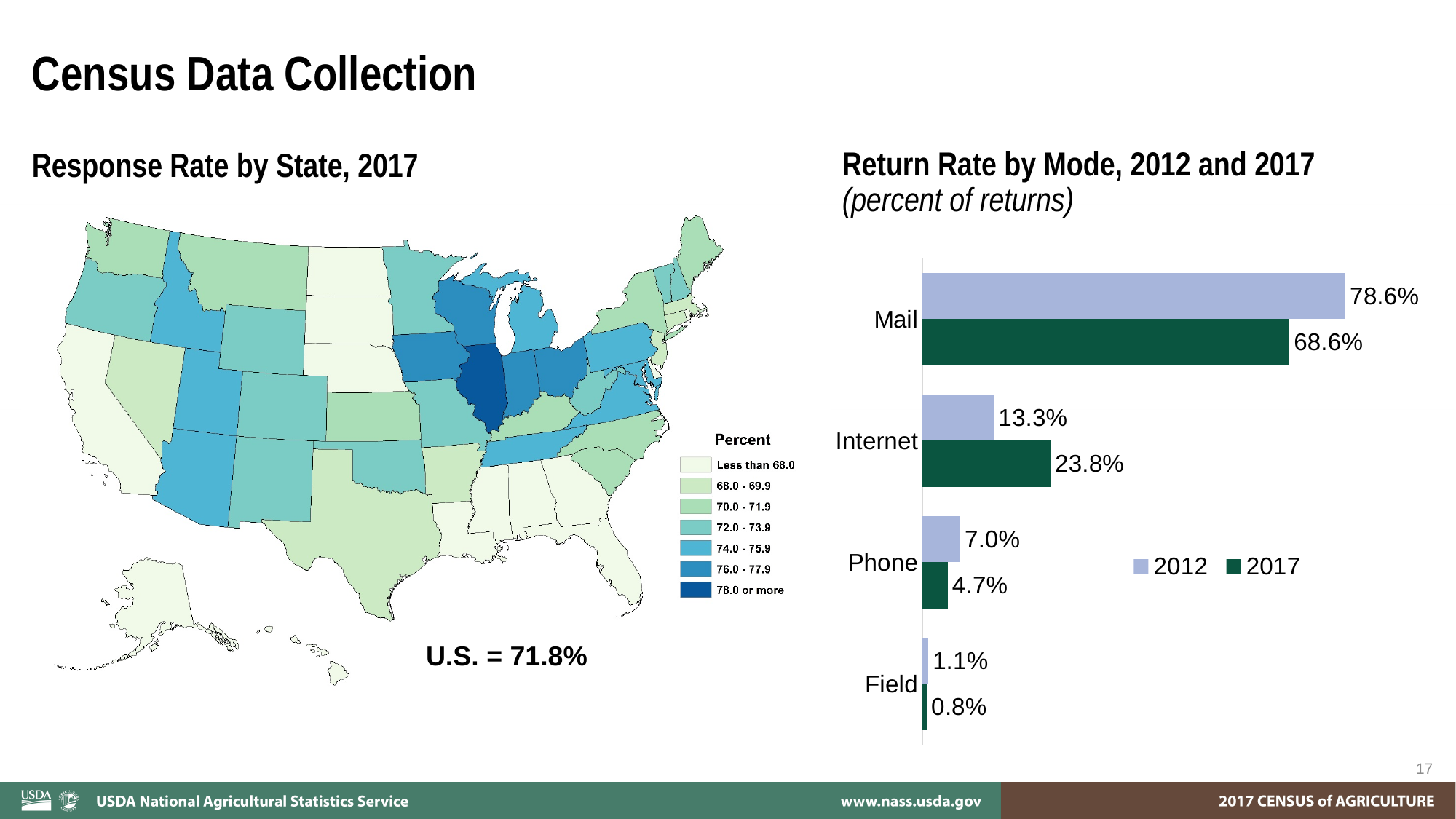
In the 'Return Rate by Mode, 2012 and 2017' chart, what is the 2017 value for Mail? 68.6% What kind of chart is the 'Return Rate by Mode, 2012 and 2017' chart? Bar chart In the 'Return Rate by Mode, 2012 and 2017' chart, what is the 2017 value for Phone? 4.7% In the 'Return Rate by Mode, 2012 and 2017' chart, by how many percentage points did the Mail return rate fall from 2012 to 2017? 10.0 percentage points How many series does the legend of the 'Return Rate by Mode, 2012 and 2017' chart list? 2 In the 'Return Rate by Mode, 2012 and 2017' chart, is the Phone return rate higher in 2012 or in 2017? 2012 In the 'Return Rate by Mode, 2012 and 2017' chart, what is the 2012 value for Internet? 13.3% In the 'Return Rate by Mode, 2012 and 2017' chart, what is the 2012 value for Field? 1.1% In the 'Return Rate by Mode, 2012 and 2017' chart, which mode has the lowest 2012 return rate? Field How many modes are shown in the 'Return Rate by Mode, 2012 and 2017' chart? 4 In the 'Return Rate by Mode, 2012 and 2017' chart, which mode has the highest 2017 return rate? Mail In the 'Return Rate by Mode, 2012 and 2017' chart, by how many percentage points did the Internet return rate rise from 2012 to 2017? 10.5 percentage points